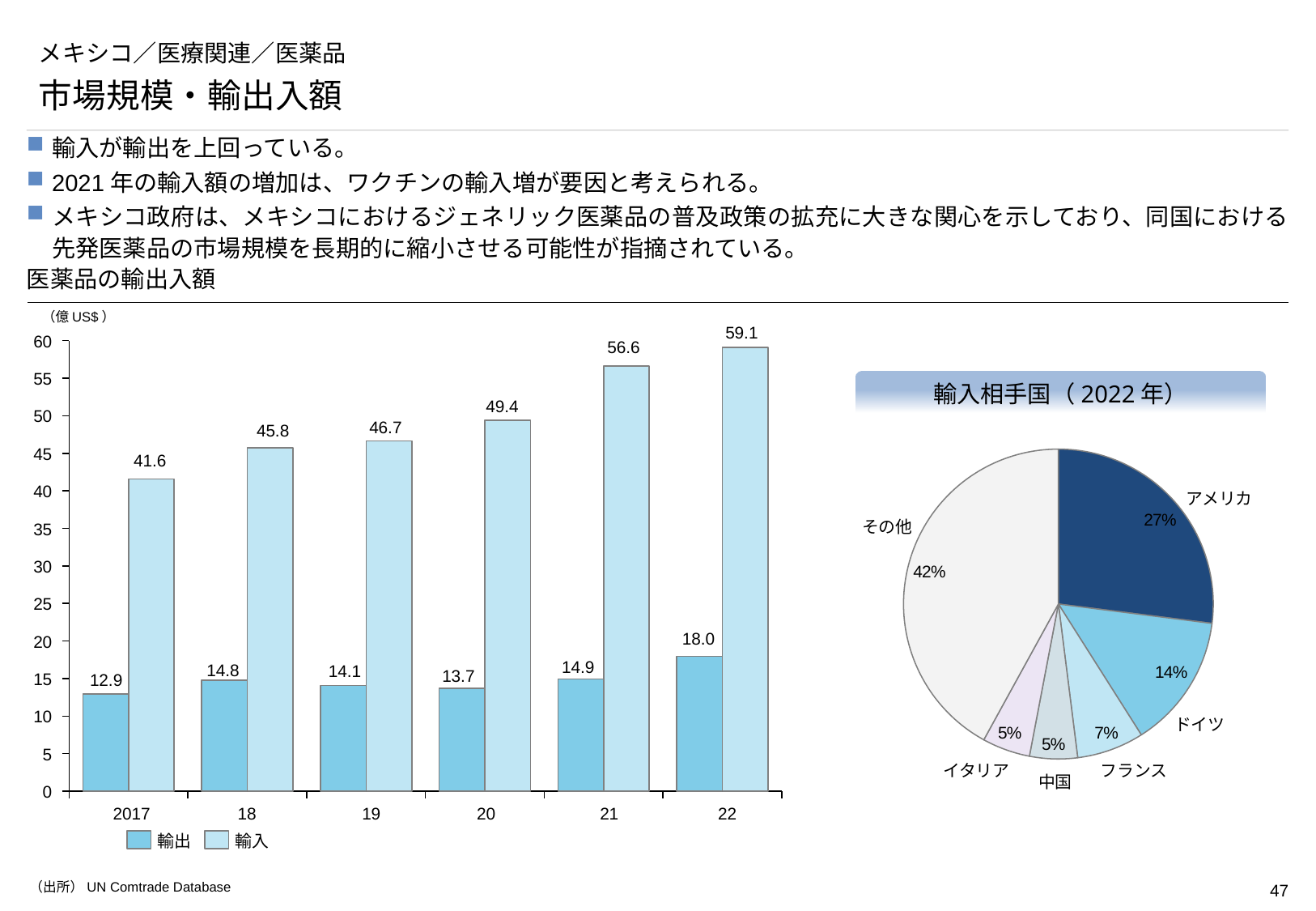
In the bar chart 医薬品の輸出入額, which year has the lowest 輸入 value? 2017 In the bar chart 医薬品の輸出入額, does the 輸入 value rise or fall from 2017 to 2022? rise In the bar chart 医薬品の輸出入額, what is the value of 輸入 for 2022? 59.1 In the pie chart 輸入相手国（2022年）, which named country has the largest share? アメリカ In the pie chart 輸入相手国（2022年）, which is larger, the share of ドイツ or the share of フランス? ドイツ In the bar chart 医薬品の輸出入額, which year has the highest 輸出 value? 22 In the pie chart 輸入相手国（2022年）, how many slices are there? 6 In the bar chart 医薬品の輸出入額, what is the value of 輸出 for 2017? 12.9 In the bar chart 医薬品の輸出入額, how many series does the legend list? 2 What kind of chart is 医薬品の輸出入額? bar chart In the bar chart 医薬品の輸出入額, what is the difference between 輸入 and 輸出 in 2021? 41.7 In the pie chart 輸入相手国（2022年）, what share does アメリカ have? 27%